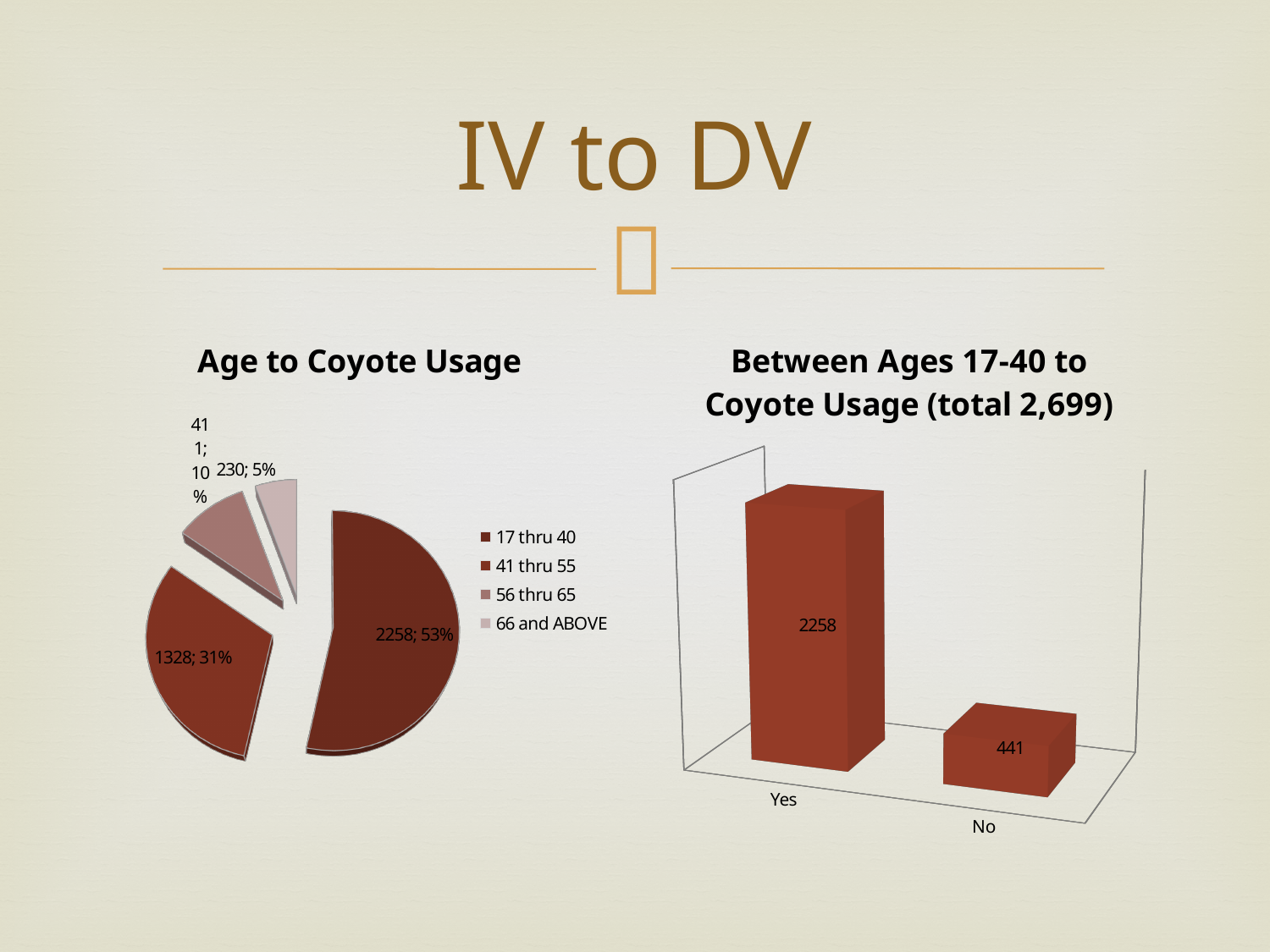
In the 'Age to Coyote Usage' chart, what value is shown for the 17 thru 40 slice? 2258; 53% How many entries does the legend of the 'Age to Coyote Usage' chart list? 4 In the 'Age to Coyote Usage' chart, what value is shown for the 66 and ABOVE slice? 230; 5% In the 'Age to Coyote Usage' chart, what value is shown for the 41 thru 55 slice? 1328; 31% What kind of chart is 'Between Ages 17-40 to Coyote Usage (total 2,699)'? Bar chart In the 'Age to Coyote Usage' chart, what share of the pie does the 41 thru 55 group represent? 31% In the 'Between Ages 17-40 to Coyote Usage' chart, what is the difference between the Yes and No values? 1817 In the 'Between Ages 17-40 to Coyote Usage' chart, what is the value for No? 441 In the 'Age to Coyote Usage' chart, which age group has the largest slice? 17 thru 40 In the 'Between Ages 17-40 to Coyote Usage' chart, what is the value for Yes? 2258 In the 'Age to Coyote Usage' chart, which age group has the smallest slice? 66 and ABOVE What kind of chart is 'Age to Coyote Usage'? Pie chart